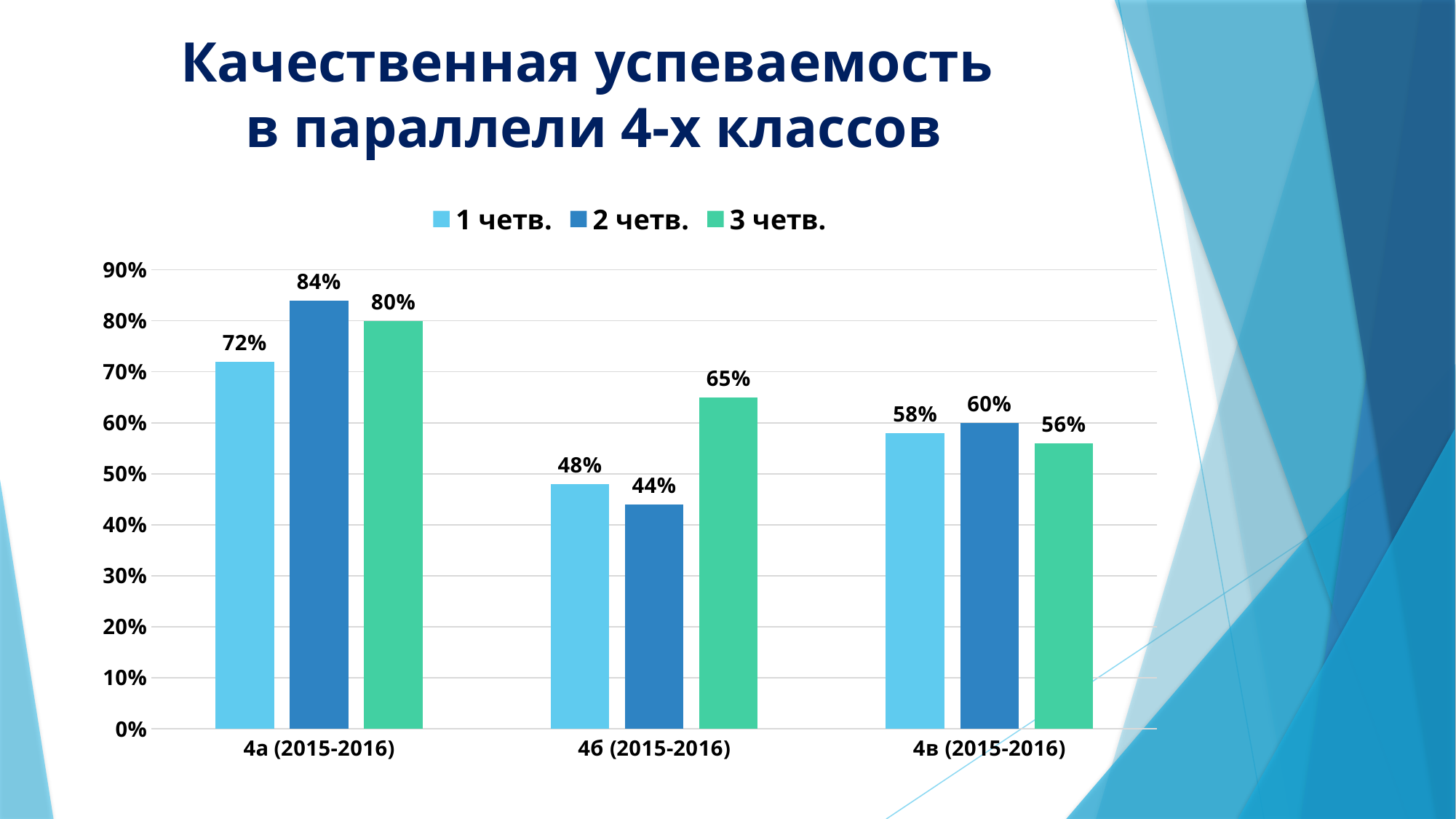
What is the value for 4а (2015-2016) in the 2 четв. series? 84% What is the value for 4б (2015-2016) in the 3 четв. series? 65% What is the difference between the 2 четв. and 1 четв. values for 4а (2015-2016)? 12% How many series does the legend list? 3 How many categories are shown on the x axis? 3 Which category has the lowest value in the 2 четв. series? 4б (2015-2016) Which is larger for 4б (2015-2016): the 1 четв. value or the 3 четв. value? 3 четв. What is the value for 4в (2015-2016) in the 1 четв. series? 58% What is the title of the slide? Качественная успеваемость в параллели 4-х классов Which category has the highest value in the 1 четв. series? 4а (2015-2016) What kind of chart is shown on the slide? Bar chart Do the values for 4б (2015-2016) rise or fall from 2 четв. to 3 четв.? Rise